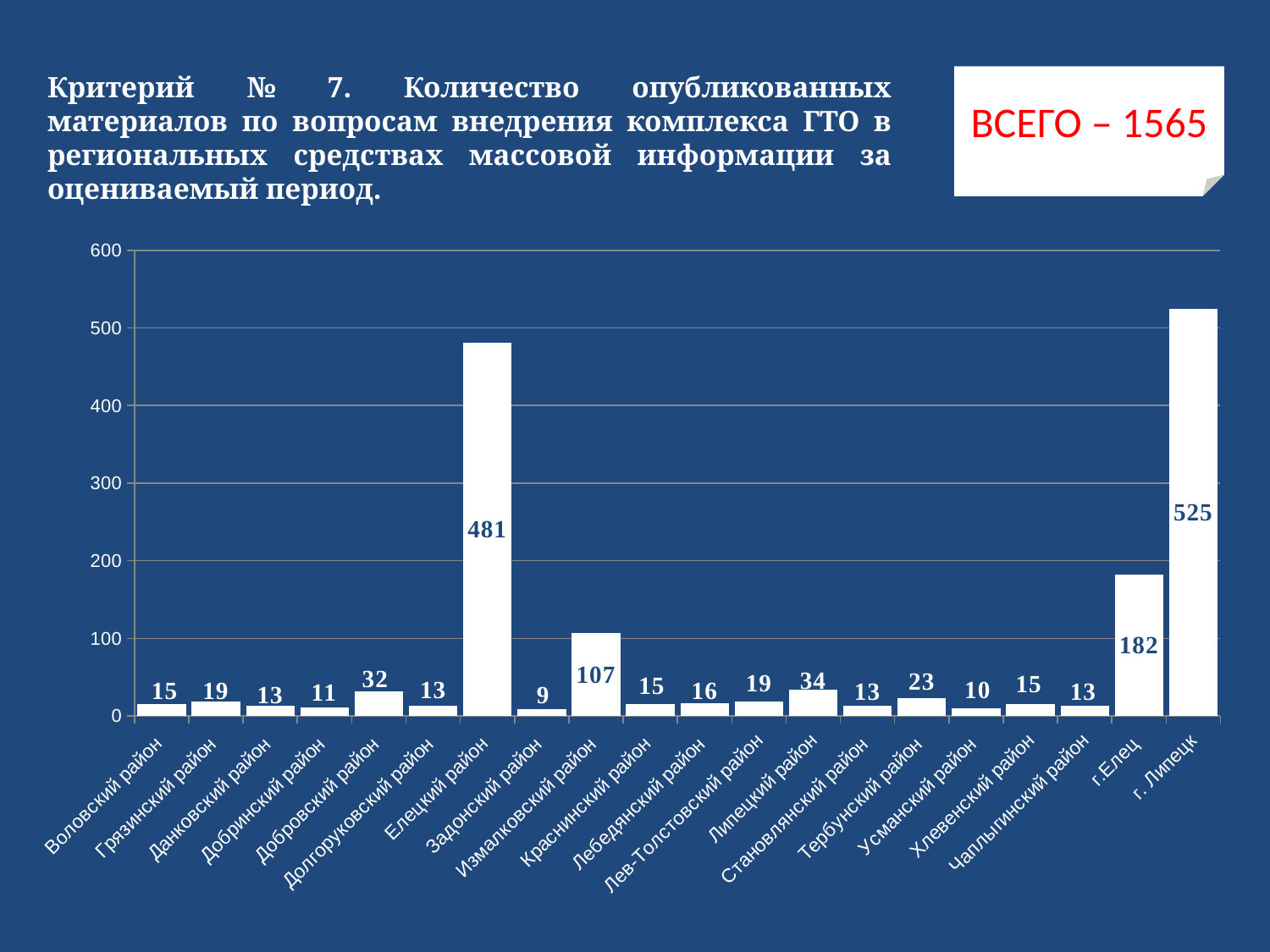
What is the difference between the values for г.Елец and Измалковский район? 75 What is the value for Тербунский район? 23 What kind of chart is shown on the slide? bar chart Which category has the highest value? г. Липецк How many categories are shown on the x axis? 20 What is the value for г. Липецк? 525 What is the value for Елецкий район? 481 What is the value for Измалковский район? 107 Which is larger, the value for Липецкий район or the value for Добровский район? Липецкий район Which category has the lowest value? Задонский район What is the difference between the values for г. Липецк and Елецкий район? 44 Is the value for г.Елец greater or less than 200? less